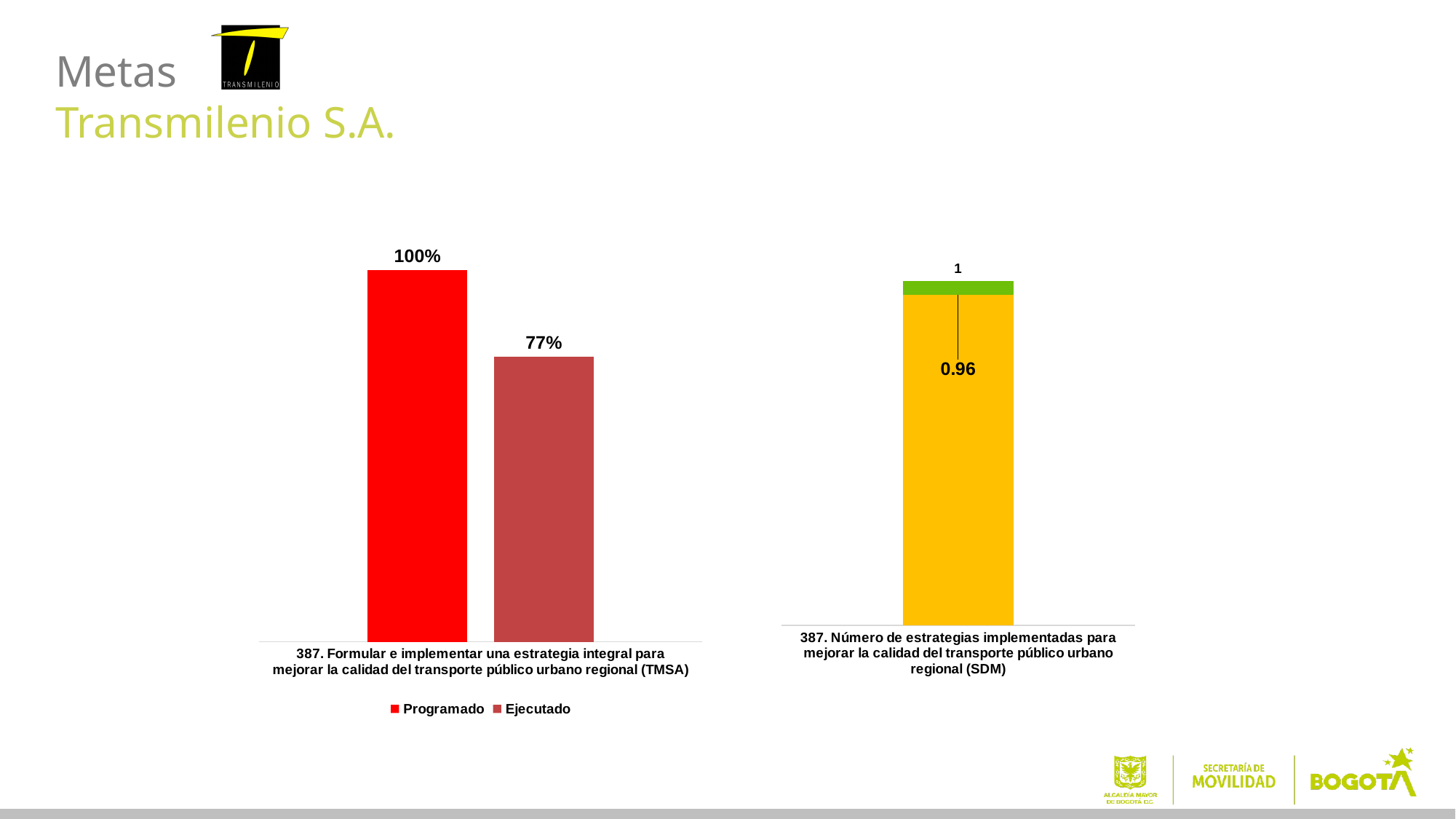
What kind of chart is the left chart (TMSA)? Bar chart In the left chart (TMSA), which series has the larger value, Programado or Ejecutado? Programado In the right chart (SDM), what value is printed inside the yellow bar? 0.96 How many series does the legend of the left chart (TMSA) list? 2 In the left chart (TMSA), what colour is the Programado bar? Red In the left chart (TMSA), what is the value for Programado? 100% In the left chart (TMSA), which series has the lowest value? Ejecutado In the right chart (SDM), what value is printed at the top of the bar? 1 What kind of chart is the right chart (SDM)? Bar chart In the left chart (TMSA), what is the difference between the Programado and Ejecutado values? 23% In the left chart (TMSA), what is the value for Ejecutado? 77% How many bars does the right chart (SDM) show? 1